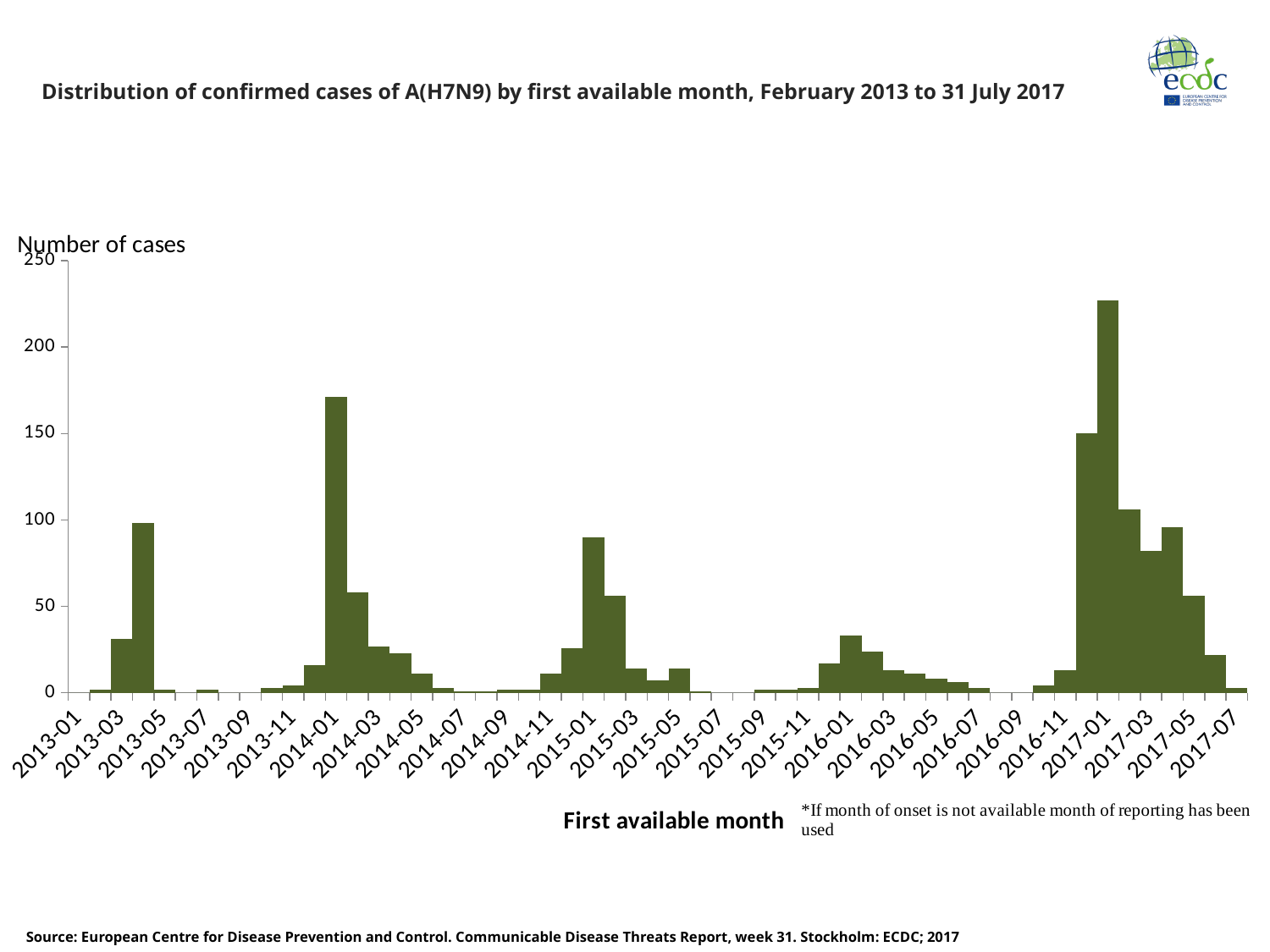
Which month has more cases, 2014-01 or 2015-01? 2014-01 Is the number of cases for 2014-01 greater or less than 150? greater Is the number of cases for 2017-01 greater or less than 200? greater Is the number of cases for 2015-01 greater or less than 100? less What is the title of the chart? Distribution of confirmed cases of A(H7N9) by first available month, February 2013 to 31 July 2017 What kind of chart is shown on the slide? bar chart What is the label on the vertical axis of the chart? Number of cases Which month has more cases, 2014-01 or 2016-01? 2014-01 Which month has the highest number of cases? 2017-01 Do the number of cases rise or fall from 2014-01 to 2014-07? fall